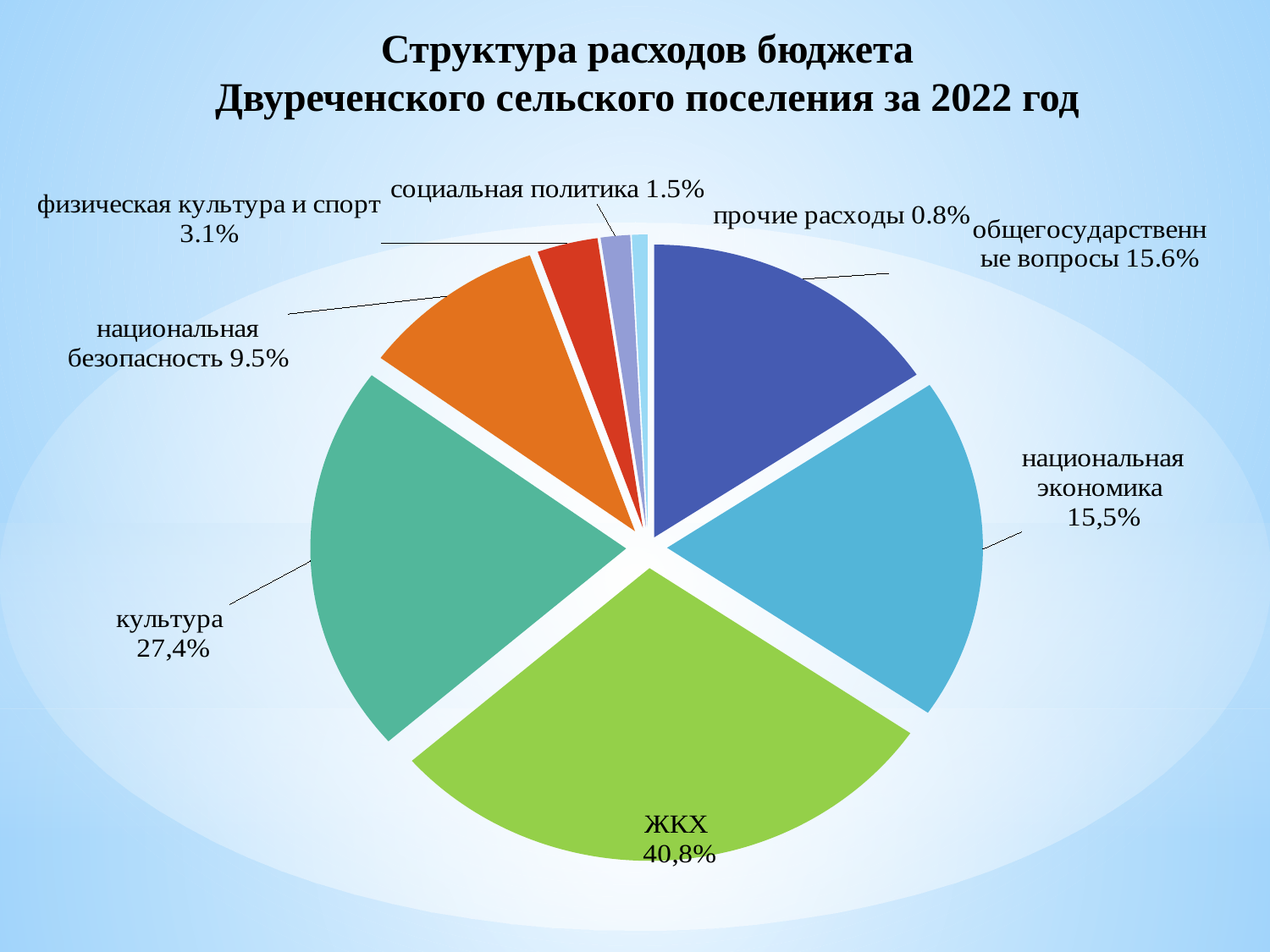
What kind of chart is shown on the slide? pie chart What share of budget expenditure is национальная безопасность? 9.5% What share of budget expenditure is культура? 27,4% What share of budget expenditure is прочие расходы? 0.8% What is the difference between the share for ЖКХ and the share for культура? 13,4% What is the title of the chart? Структура расходов бюджета Двуреченского сельского поселения за 2022 год Which category has the smallest share of the budget expenditure? прочие расходы What share of budget expenditure is социальная политика? 1.5% Which category has the largest share of the budget expenditure? ЖКХ Which is larger, the share for культура or the share for национальная безопасность? культура What share of budget expenditure is ЖКХ? 40,8% How many categories does the pie chart show? 8